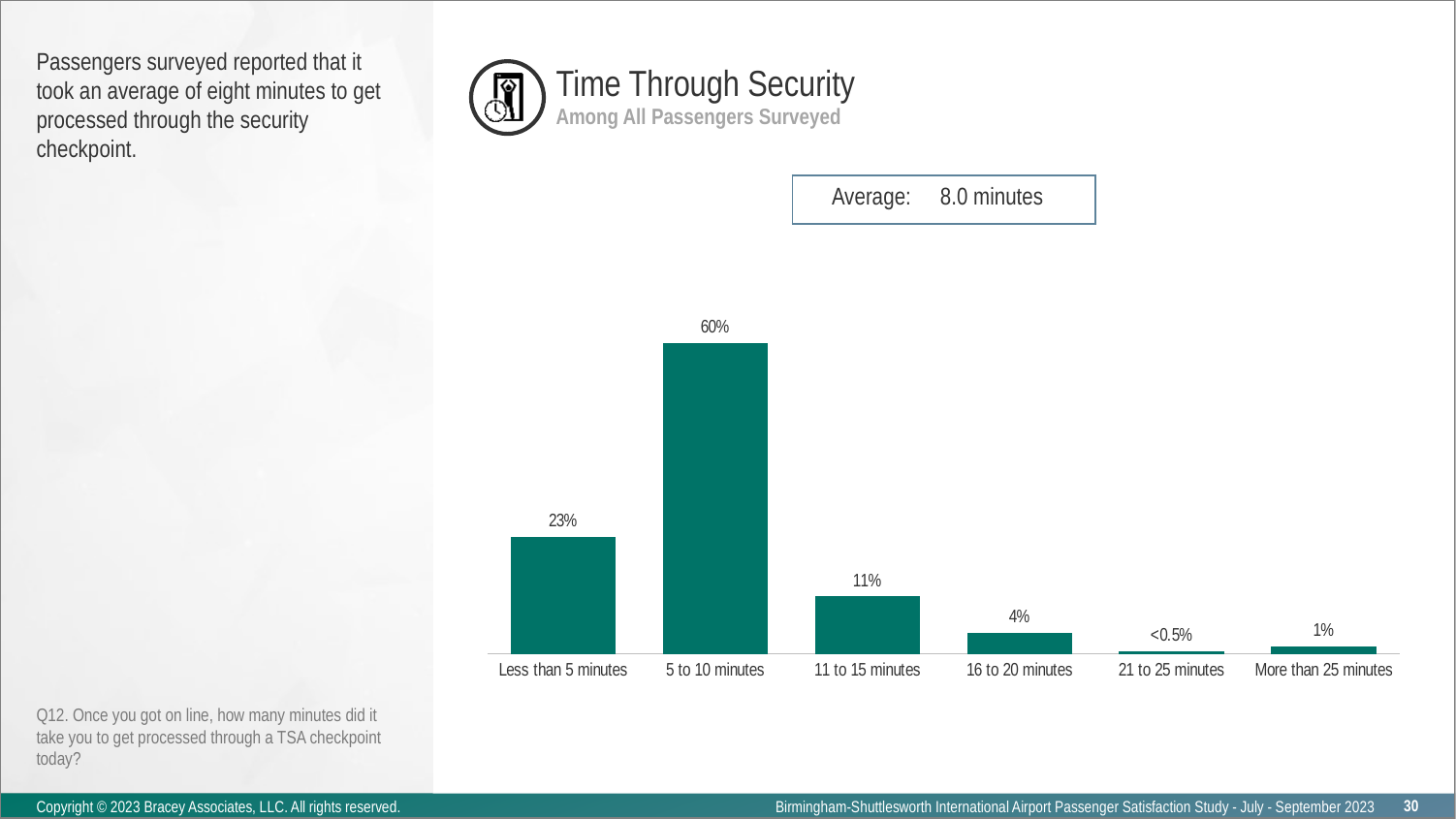
What kind of chart is used to show time through security? Bar chart What is the subtitle of the chart? Among All Passengers Surveyed Which time category has the highest percentage of passengers? 5 to 10 minutes Which time category has the lowest percentage of passengers? 21 to 25 minutes What percentage of passengers reported taking 5 to 10 minutes to get through security? 60% What is the average time through security shown on the slide? 8.0 minutes What is the data label shown for the 21 to 25 minutes category? <0.5% What percentage of passengers reported taking 11 to 15 minutes? 11% How many time categories are shown on the chart? 6 What is the difference in percentage points between the 5 to 10 minutes and less than 5 minutes categories? 37 Which is larger: the percentage for 16 to 20 minutes or for more than 25 minutes? 16 to 20 minutes What percentage of passengers reported taking less than 5 minutes to get through security? 23%